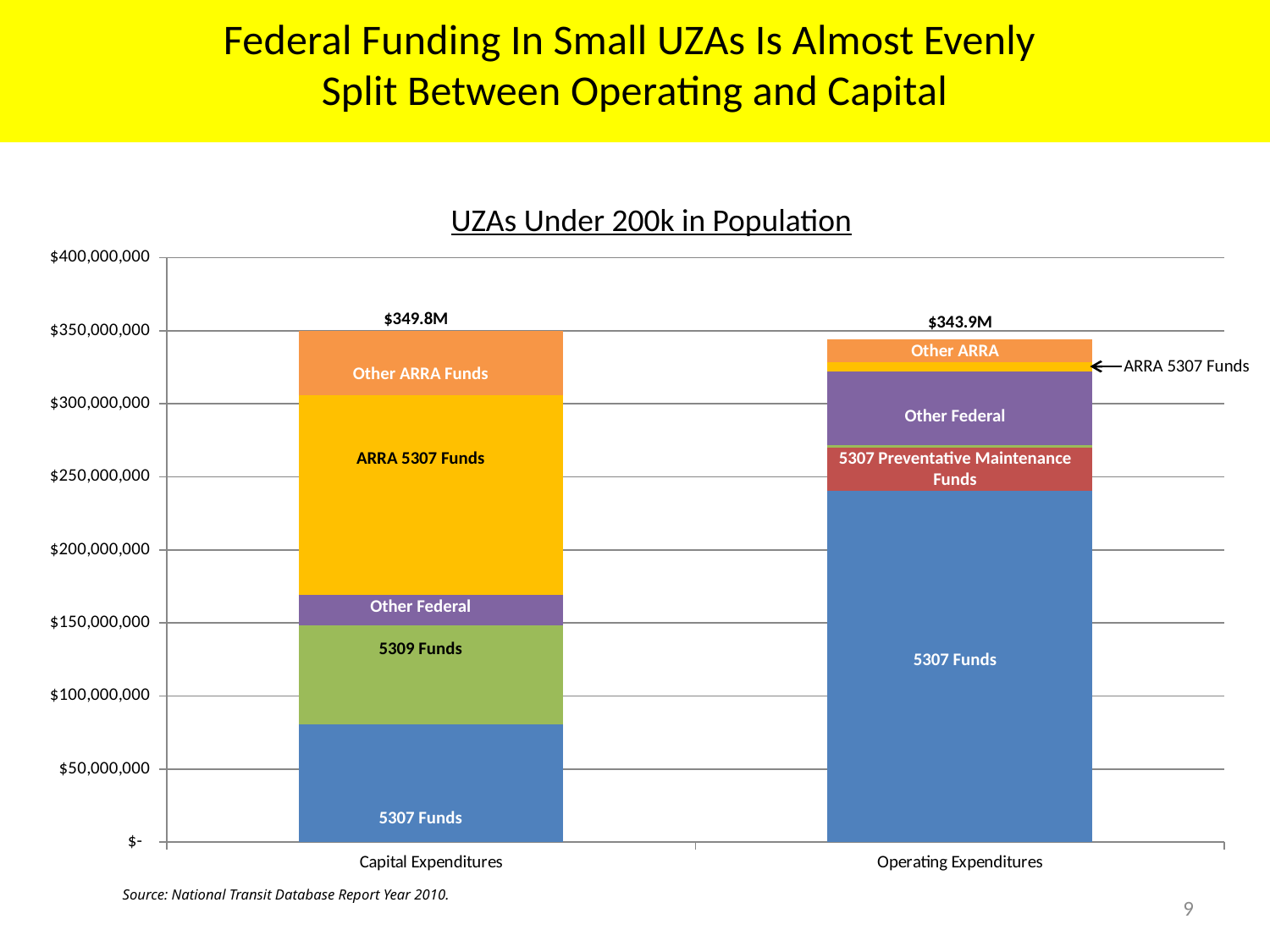
Which segment is the largest in the Operating Expenditures bar? 5307 Funds How many expenditure categories are plotted on the x axis? 2 What kind of chart is shown on the slide? Stacked bar chart What is the title of the chart? UZAs Under 200k in Population What is the difference between the Capital Expenditures total and the Operating Expenditures total? $5.9M Which bar has the larger total, Capital Expenditures or Operating Expenditures? Capital Expenditures What is the total labeled above the Capital Expenditures bar? $349.8M Is the 5307 Funds segment in the Capital Expenditures bar greater or less than $100,000,000? less Is the 5307 Funds segment in the Operating Expenditures bar greater or less than $200,000,000? greater What is the total labeled above the Operating Expenditures bar? $343.9M Which segment is the largest in the Capital Expenditures bar? ARRA 5307 Funds What source is cited below the chart? National Transit Database Report Year 2010